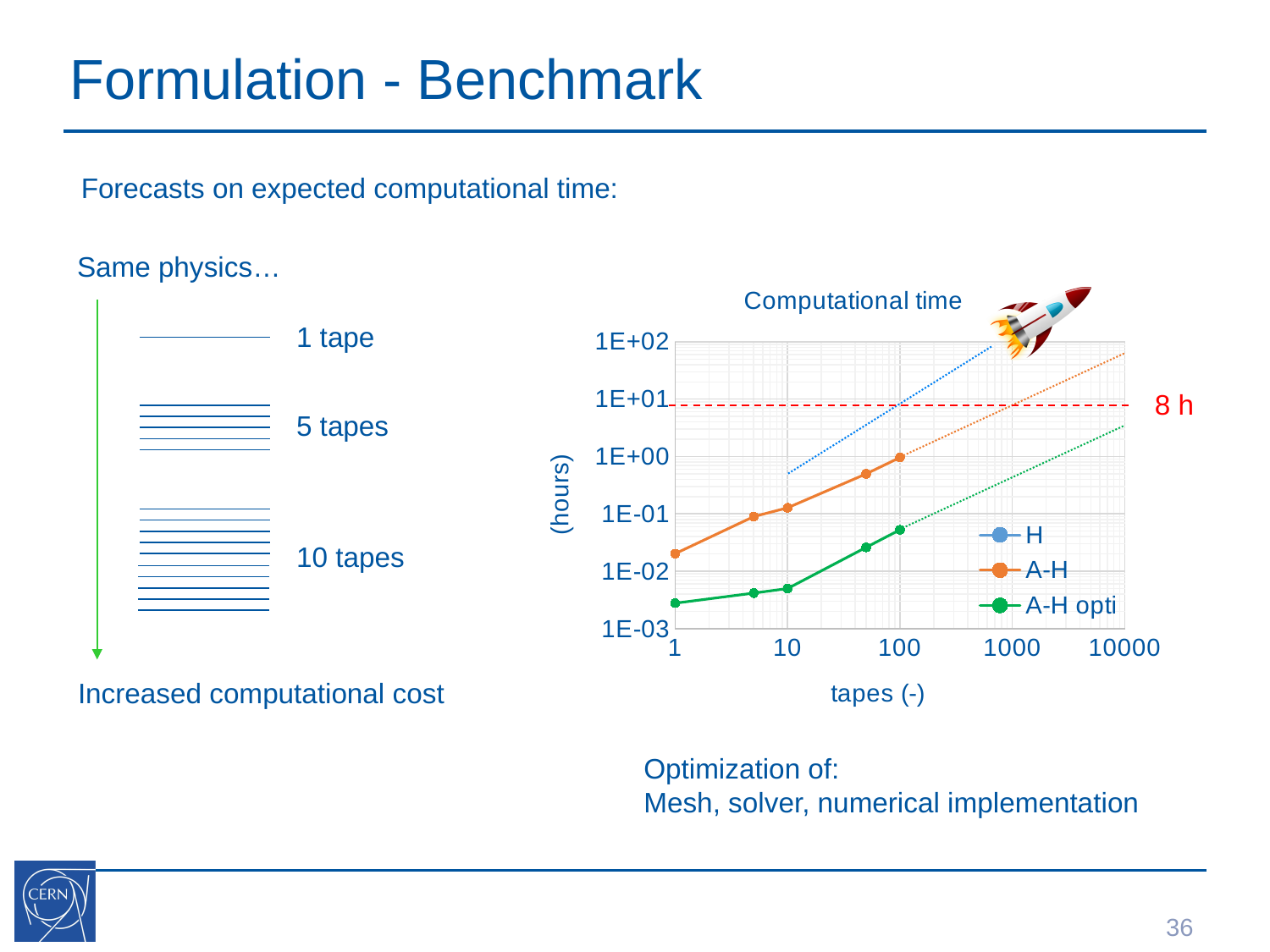
Is the value for A-H at 10 tapes greater or less than 1E+00 hours? less Is the value for A-H at 1 tape greater or less than 1E-01 hours? less What label is attached to the red dashed horizontal line on the chart? 8 h Is the value for A-H at 100 tapes greater or less than 1E-01 hours? greater How many series does the legend of the chart list? 3 At 100 tapes, which series has the larger computational time, A-H or A-H opti? A-H What kind of chart is shown on the slide? line chart How many data points are plotted for the A-H opti series? 5 Does the computational time for A-H rise or fall as the number of tapes increases? rise What is the title of the chart? Computational time